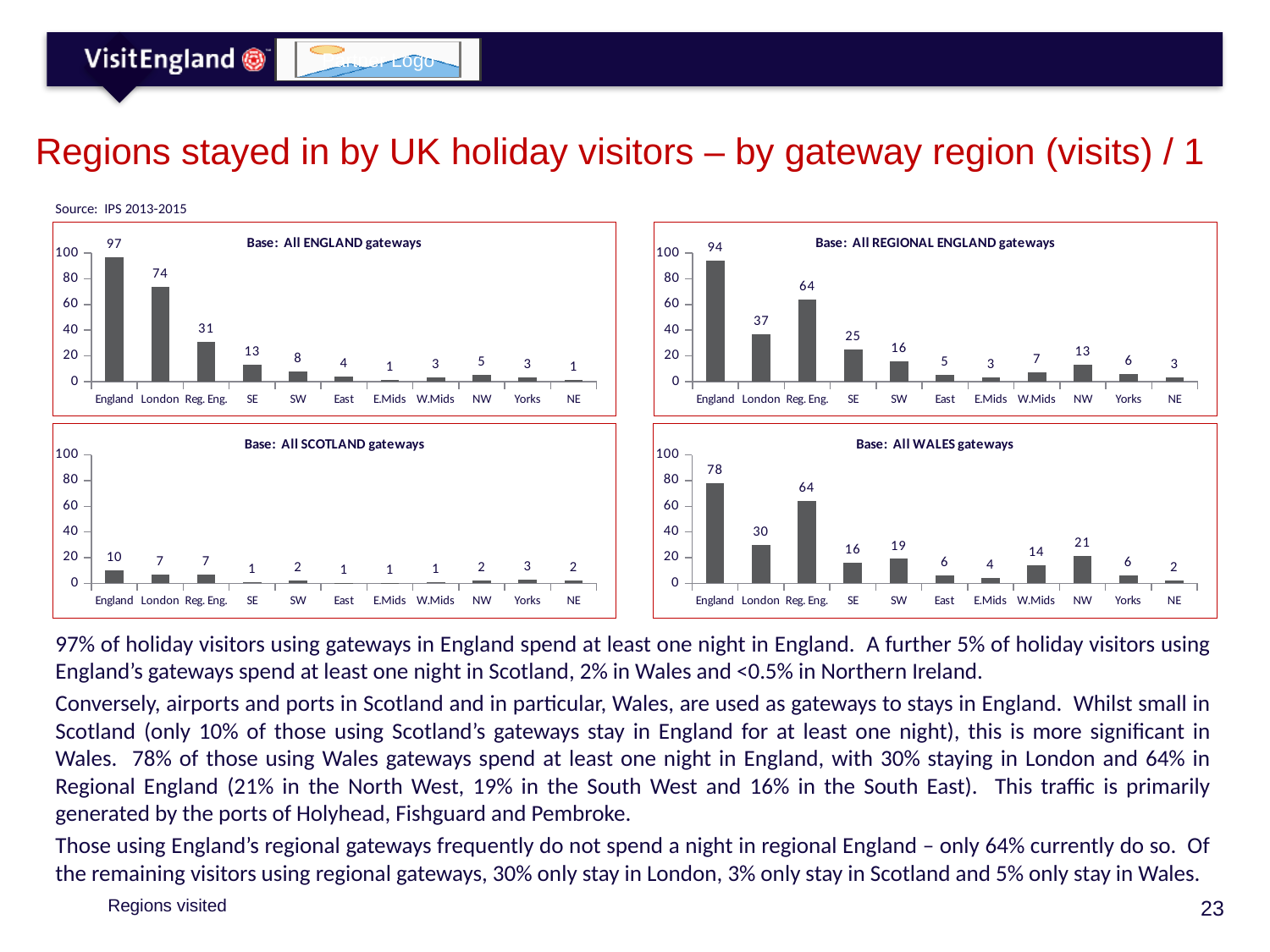
In the 'Base: All WALES gateways' chart, what is the value for SW? 19 In the 'Base: All REGIONAL ENGLAND gateways' chart, what is the value for Reg. Eng.? 64 In the 'Base: All ENGLAND gateways' chart, which category has the highest value? England What type of chart is the 'Base: All WALES gateways' chart? Bar chart How many categories are shown on the x axis of the 'Base: All SCOTLAND gateways' chart? 11 In the 'Base: All WALES gateways' chart, what is the difference between the values for Reg. Eng. and London? 34 In the 'Base: All WALES gateways' chart, what is the value for NW? 21 In the 'Base: All SCOTLAND gateways' chart, which category has the highest value? England In the 'Base: All ENGLAND gateways' chart, what is the value for London? 74 In the 'Base: All ENGLAND gateways' chart, what is the difference between the values for England and London? 23 In the 'Base: All REGIONAL ENGLAND gateways' chart, which is larger, the value for SE or the value for SW? SE How many charts are shown on the slide? 4